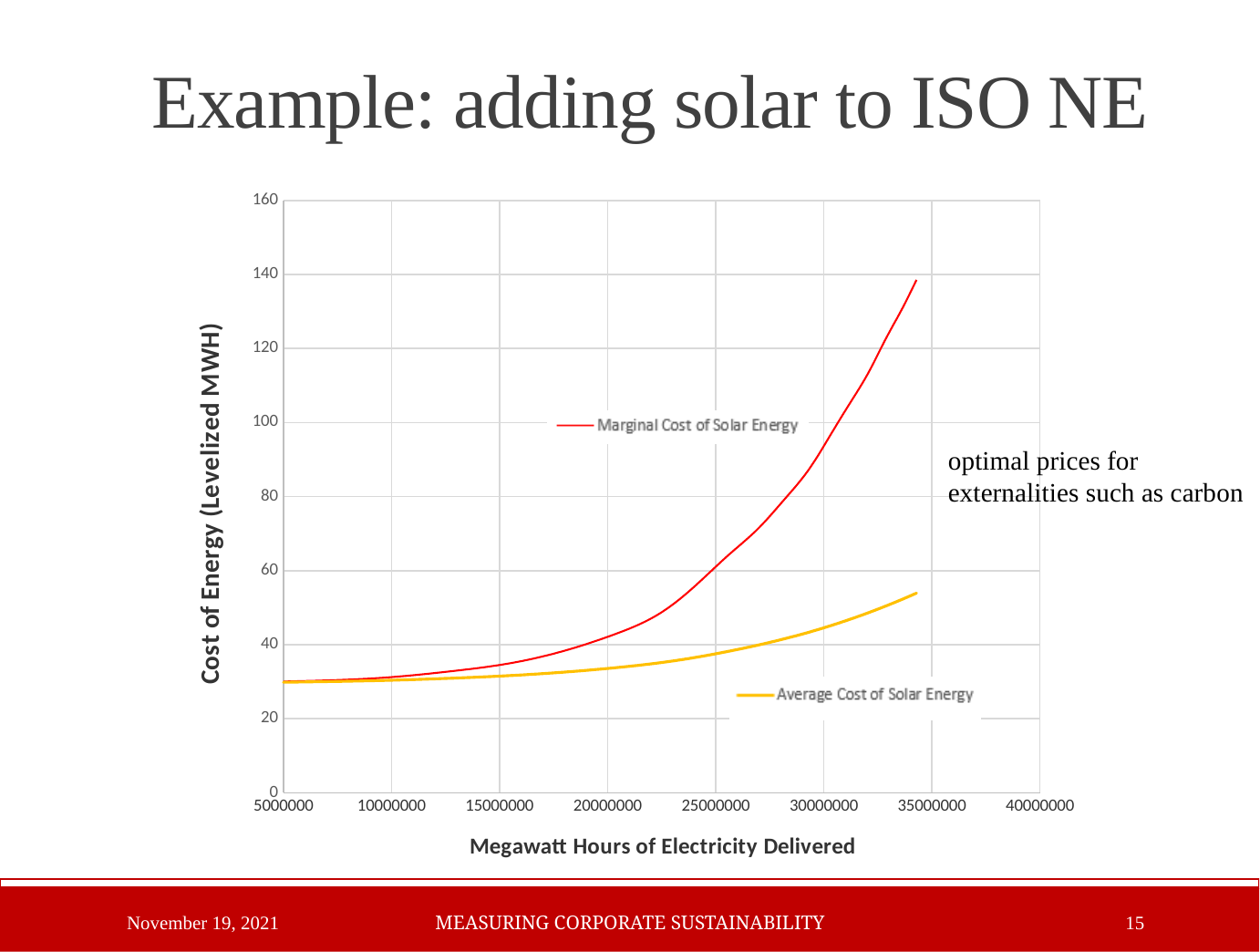
Is the value of Average Cost of Solar Energy at 20000000 megawatt hours greater or less than 40? less Does the Average Cost of Solar Energy rise or fall as Megawatt Hours of Electricity Delivered increases? rise What kind of chart is shown on the slide? line chart Is the highest value reached by the Average Cost of Solar Energy line greater or less than 60? less Which series is drawn in red? Marginal Cost of Solar Energy What is the title of the y axis? Cost of Energy (Levelized MWH) Does the Marginal Cost of Solar Energy rise or fall as Megawatt Hours of Electricity Delivered increases? rise How many series does the chart show? 2 Is the highest value reached by the Marginal Cost of Solar Energy line greater or less than 120? greater At 30000000 megawatt hours, which series has the higher value, Marginal Cost of Solar Energy or Average Cost of Solar Energy? Marginal Cost of Solar Energy